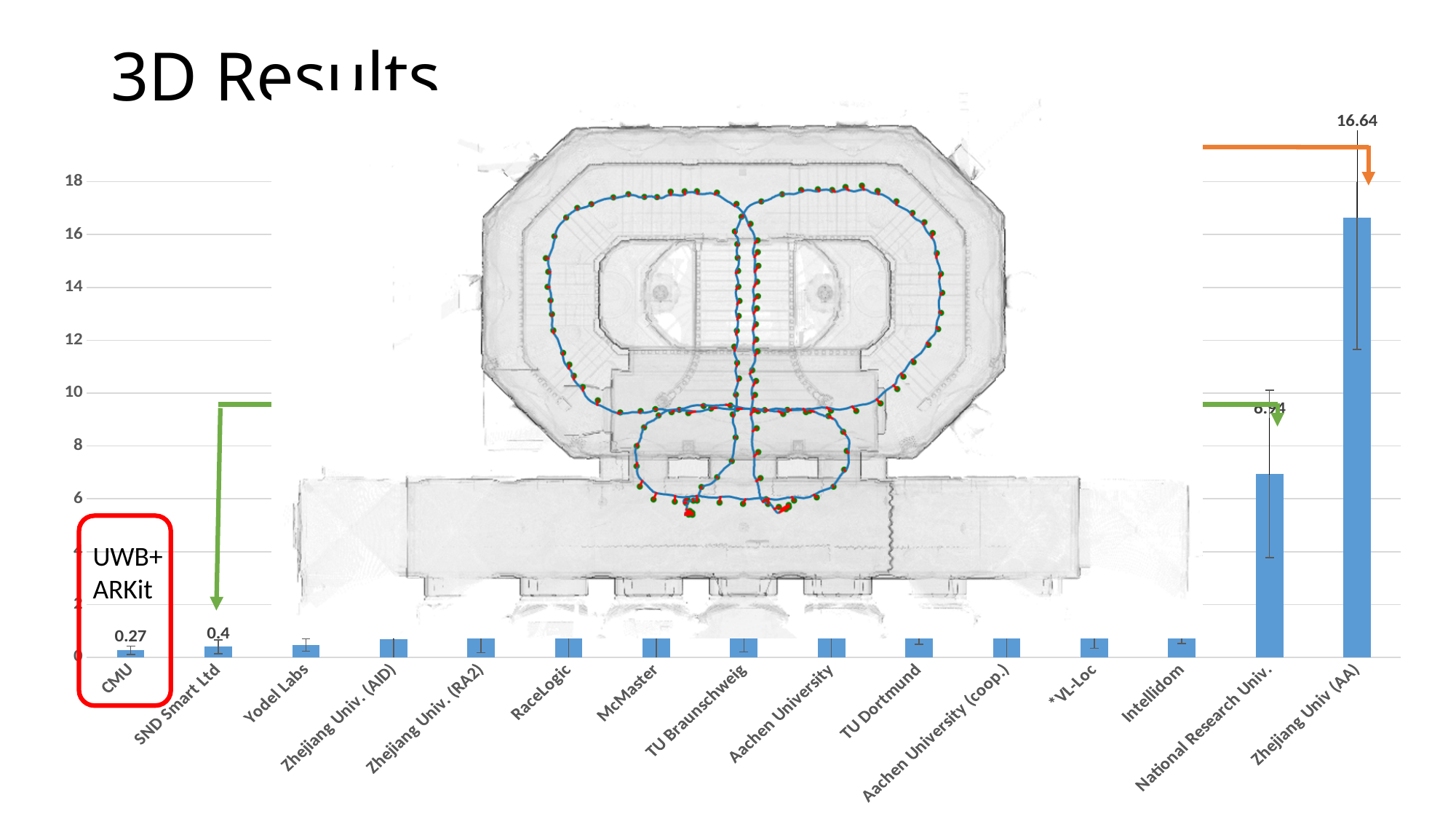
What kind of chart is shown on the slide? bar chart What is the value for Zhejiang Univ (AA)? 16.64 Which category has the highest value? Zhejiang Univ (AA) Which category has the lowest value? CMU Which is larger, the value for CMU or the value for SND Smart Ltd? SND Smart Ltd What is the difference between the values for Zhejiang Univ (AA) and CMU? 16.37 How many categories are shown on the x axis? 15 Is the value for National Research Univ. greater or less than 6? greater What is the value for SND Smart Ltd? 0.4 Is the value for Yodel Labs greater or less than 2? less What label is written inside the red box around the CMU bar? UWB+ARKit What is the value for CMU? 0.27